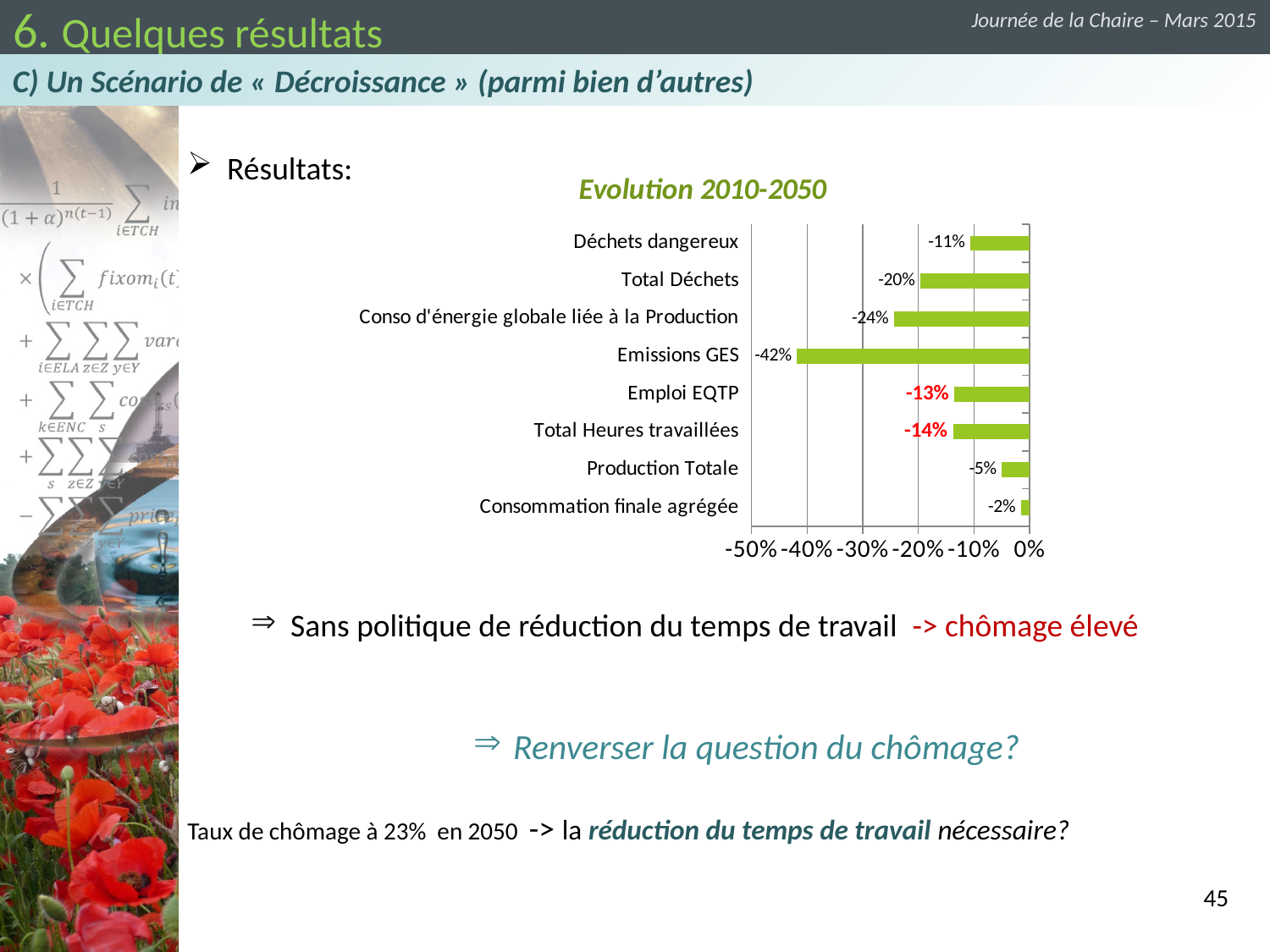
Which shows a larger decrease: Total Heures travaillées or Production Totale? Total Heures travaillées Is the value for Conso d'énergie globale liée à la Production greater or less than -20%? less By how many percentage points does the decrease for Total Déchets exceed that for Déchets dangereux? 9 percentage points What is the value shown for Emissions GES in the Evolution 2010-2050 chart? -42% How many categories are plotted in the Evolution 2010-2050 chart? 8 What is the value shown for Total Déchets? -20% Which two data labels in the chart are printed in red? Emploi EQTP (-13%) and Total Heures travaillées (-14%) What kind of chart is used to show the Evolution 2010-2050 data? Bar chart What is the value shown for Emploi EQTP? -13% What is the value shown for Consommation finale agrégée? -2% Which category shows the largest decrease in the chart? Emissions GES Which category shows the smallest decrease in the chart? Consommation finale agrégée